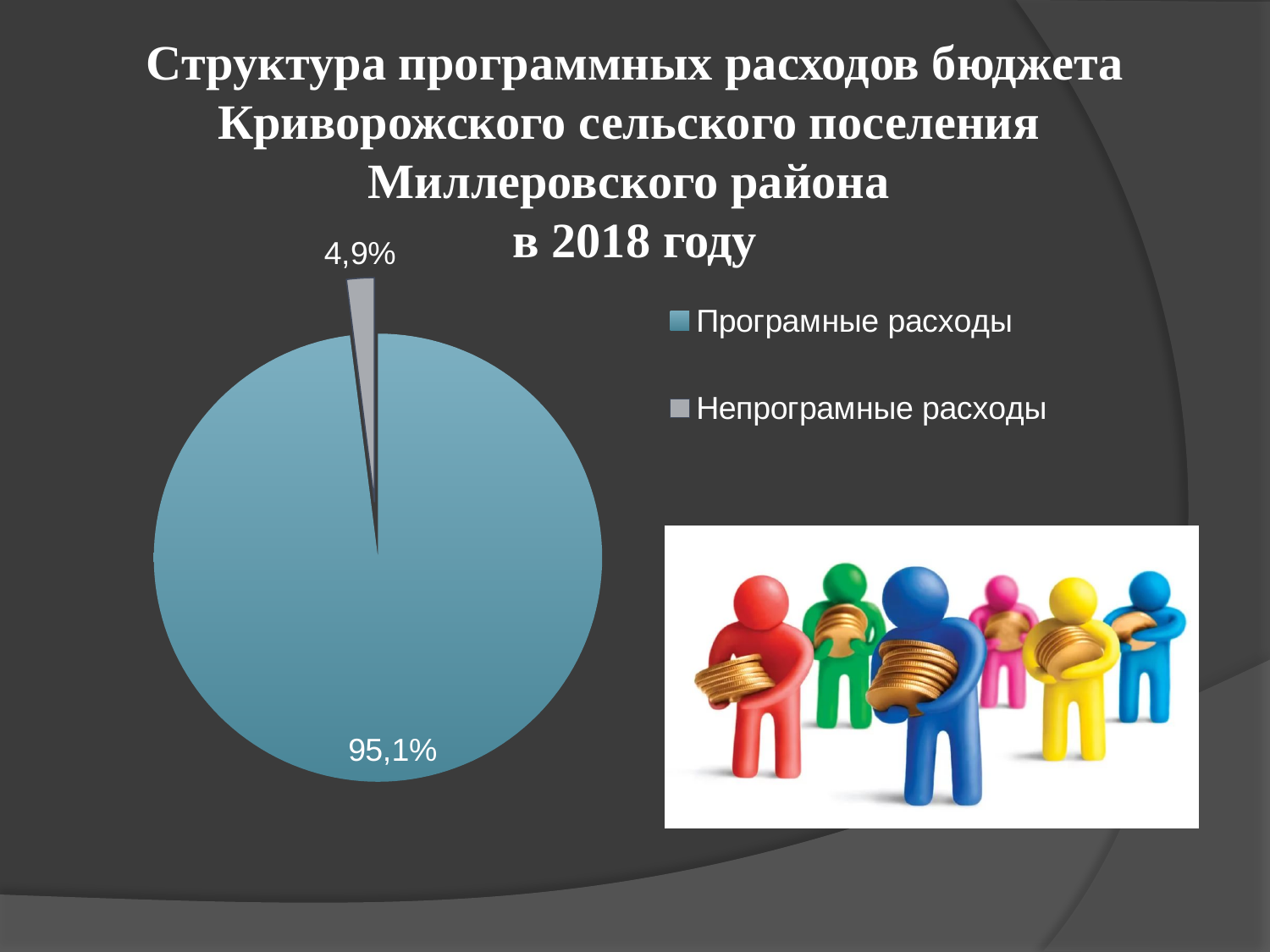
How many entries does the legend list? 2 Which category has the largest slice of the pie? Програмные расходы Which slice is larger: Програмные расходы or Непрограмные расходы? Програмные расходы What colour is the slice for Непрограмные расходы? Grey What is the difference in percentage points between the Програмные расходы slice and the Непрограмные расходы slice? 90,2 How many slices does the pie chart have? 2 What kind of chart is shown on the slide? Pie chart What share of the pie is labelled for Непрограмные расходы? 4,9% What share of the pie is labelled for Програмные расходы? 95,1% What is the total of the two slice labels shown on the pie? 100% Which category has the smallest slice of the pie? Непрограмные расходы What colour is the slice for Програмные расходы? Blue